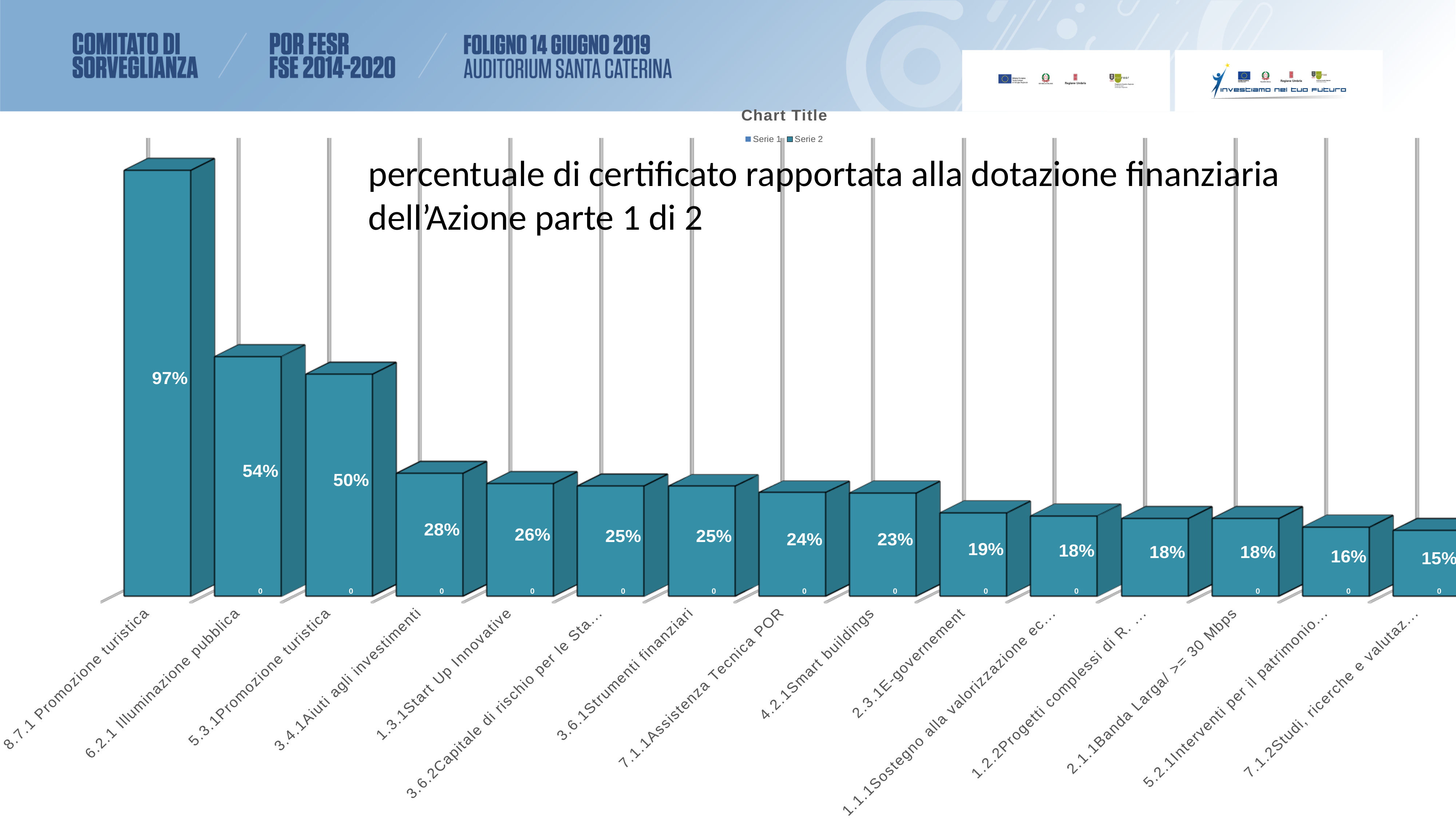
What is the value for 4.2.1 Smart buildings? 23% What is the value for 2.1.1 Banda Larga/ >= 30 Mbps? 18% What is the value for 8.7.1 Promozione turistica? 97% How many categories are shown on the x axis? 15 Which category has the lowest value? 7.1.2 Studi, ricerche e valutaz... Which category has the highest value? 8.7.1 Promozione turistica How many series does the legend list? 2 What is the difference between the values for 8.7.1 Promozione turistica and 6.2.1 Illuminazione pubblica? 43% What kind of chart is shown on the slide? bar chart Which is larger, the value for 3.4.1 Aiuti agli investimenti or the value for 2.3.1 E-governement? 3.4.1 Aiuti agli investimenti What is the value for 6.2.1 Illuminazione pubblica? 54% Do the values rise or fall from left to right along the x axis? fall